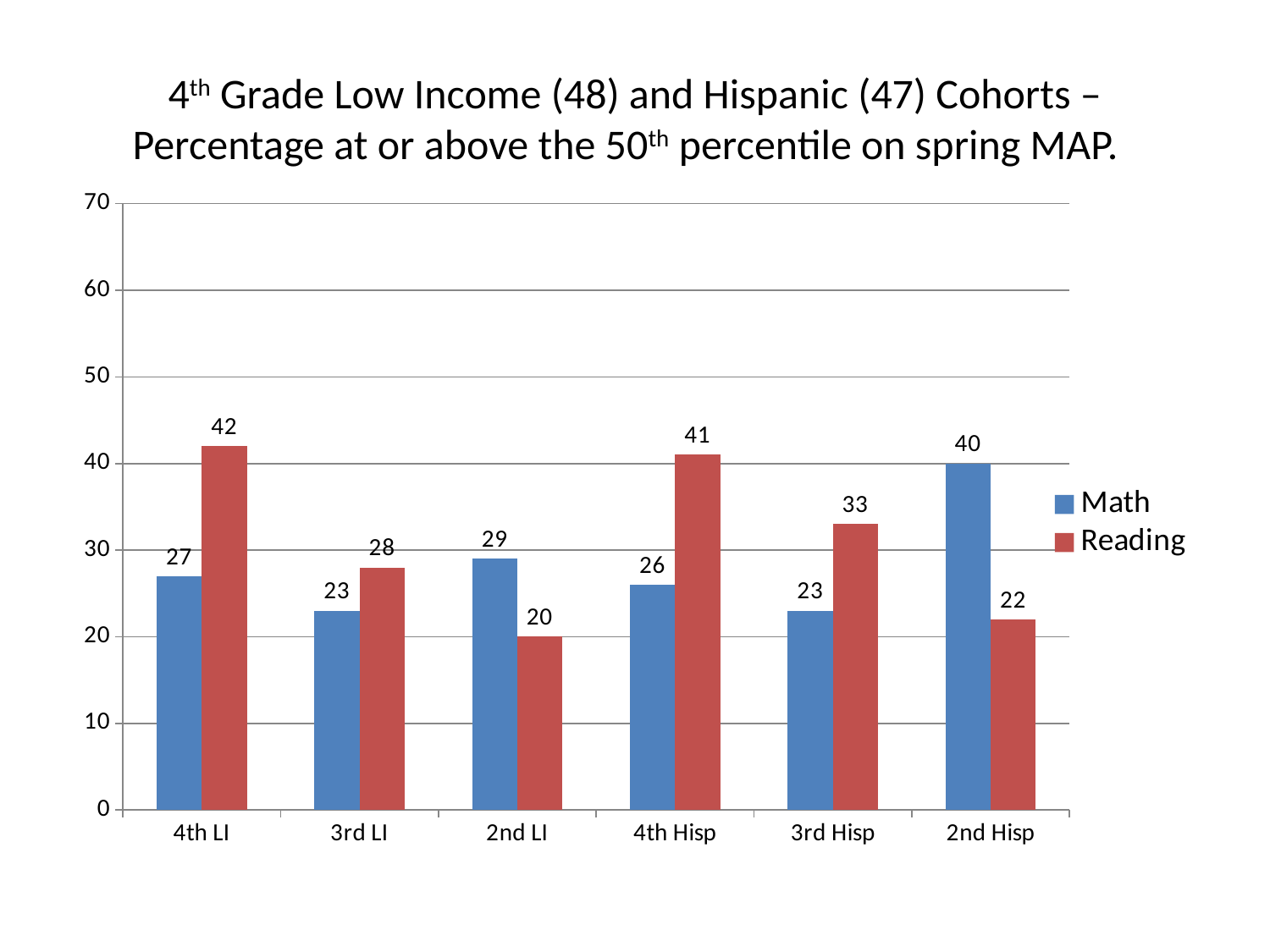
Which category has the lowest Reading value? 2nd LI Which category has the highest Math value? 2nd Hisp How many series does the legend list? 2 What is the Reading value for 2nd Hisp? 22 Which colour represents the Reading series? Red What is the Math value for 4th LI? 27 What is the Reading value for 3rd Hisp? 33 How many categories are shown on the x axis? 6 What is the difference between the Reading and Math values for 4th Hisp? 15 Which category has the highest Reading value? 4th LI What kind of chart is shown on the slide? Bar chart Which is larger for 2nd LI, Math or Reading? Math